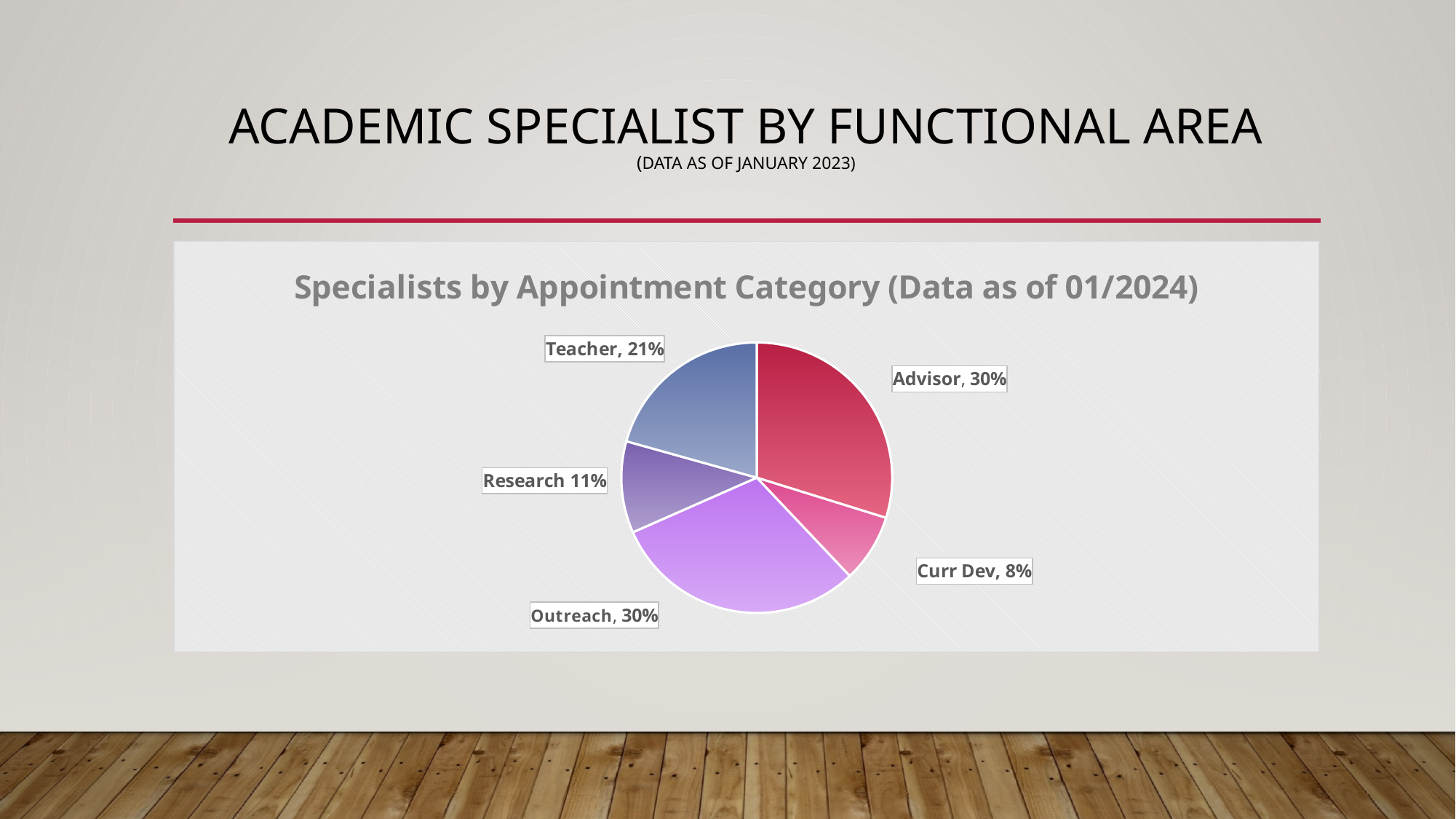
What kind of chart is shown on the slide? pie chart Which two categories share the same percentage of 30%? Advisor and Outreach What is the difference in percentage points between the Teacher share and the Research share? 10 Which category has the smallest share of the pie? Curr Dev What is the difference in percentage points between the Outreach share and the Curr Dev share? 22 Which is larger, the Teacher share or the Research share? Teacher What share of specialists are in the Teacher category? 21% What share of specialists are in the Research category? 11% What is the title of the chart? Specialists by Appointment Category (Data as of 01/2024) How many categories does the pie chart show? 5 What share of specialists are in the Advisor category? 30%